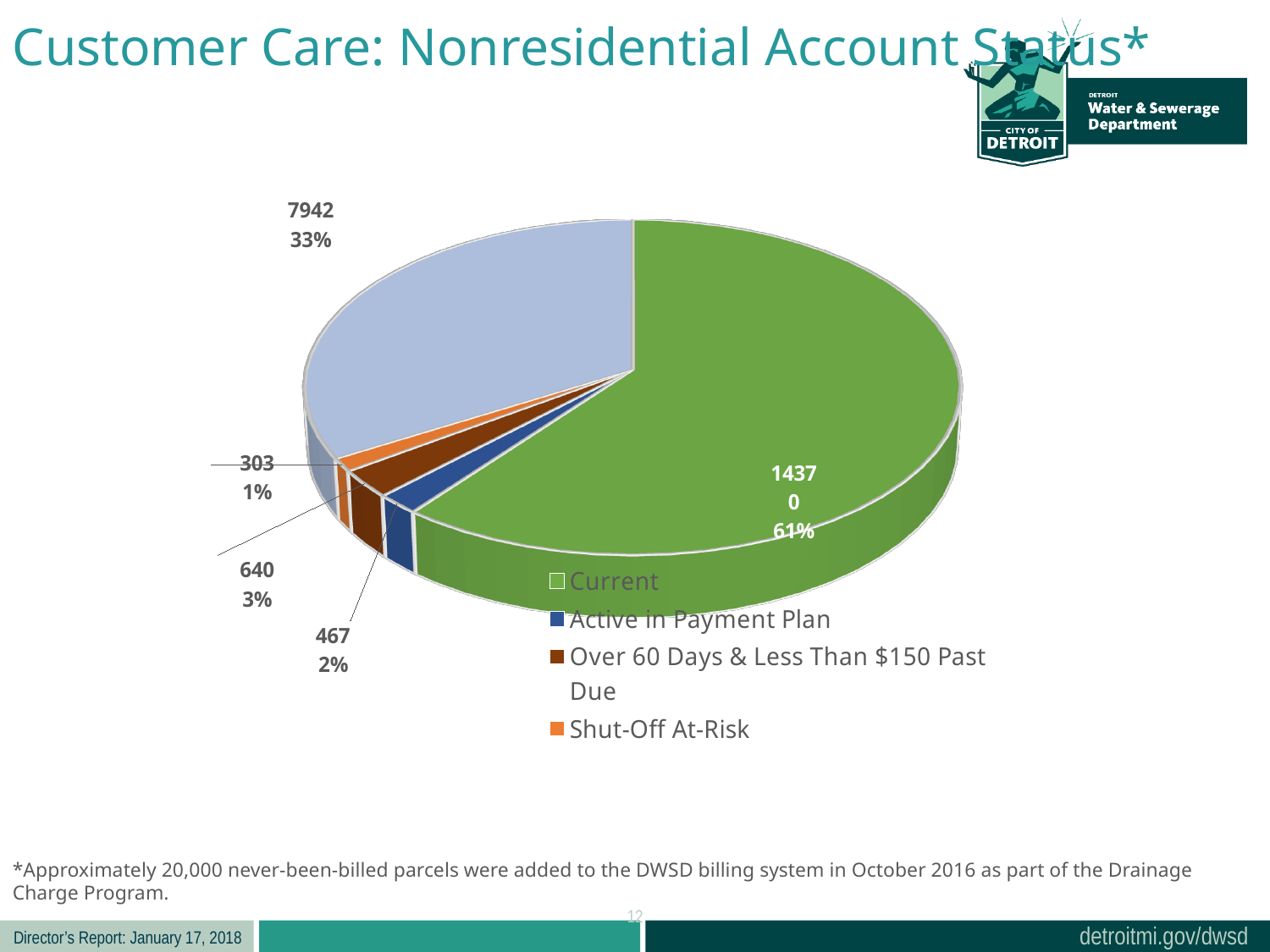
How many accounts are Shut-Off At-Risk? 303 How many accounts are Over 60 Days & Less Than $150 Past Due? 640 How many accounts are Active in Payment Plan? 467 What is the number of accounts labelled as Current? 14370 How many slices does the pie chart have? 5 How many entries does the chart legend list? 4 Which category has the largest slice of the pie? Current Which category has the smallest slice of the pie? Shut-Off At-Risk What percentage of nonresidential accounts are Current? 61% What type of chart is shown on the slide? pie chart What share of the pie is Shut-Off At-Risk? 1% What is the difference between the number of accounts Over 60 Days & Less Than $150 Past Due and the number Active in Payment Plan? 173